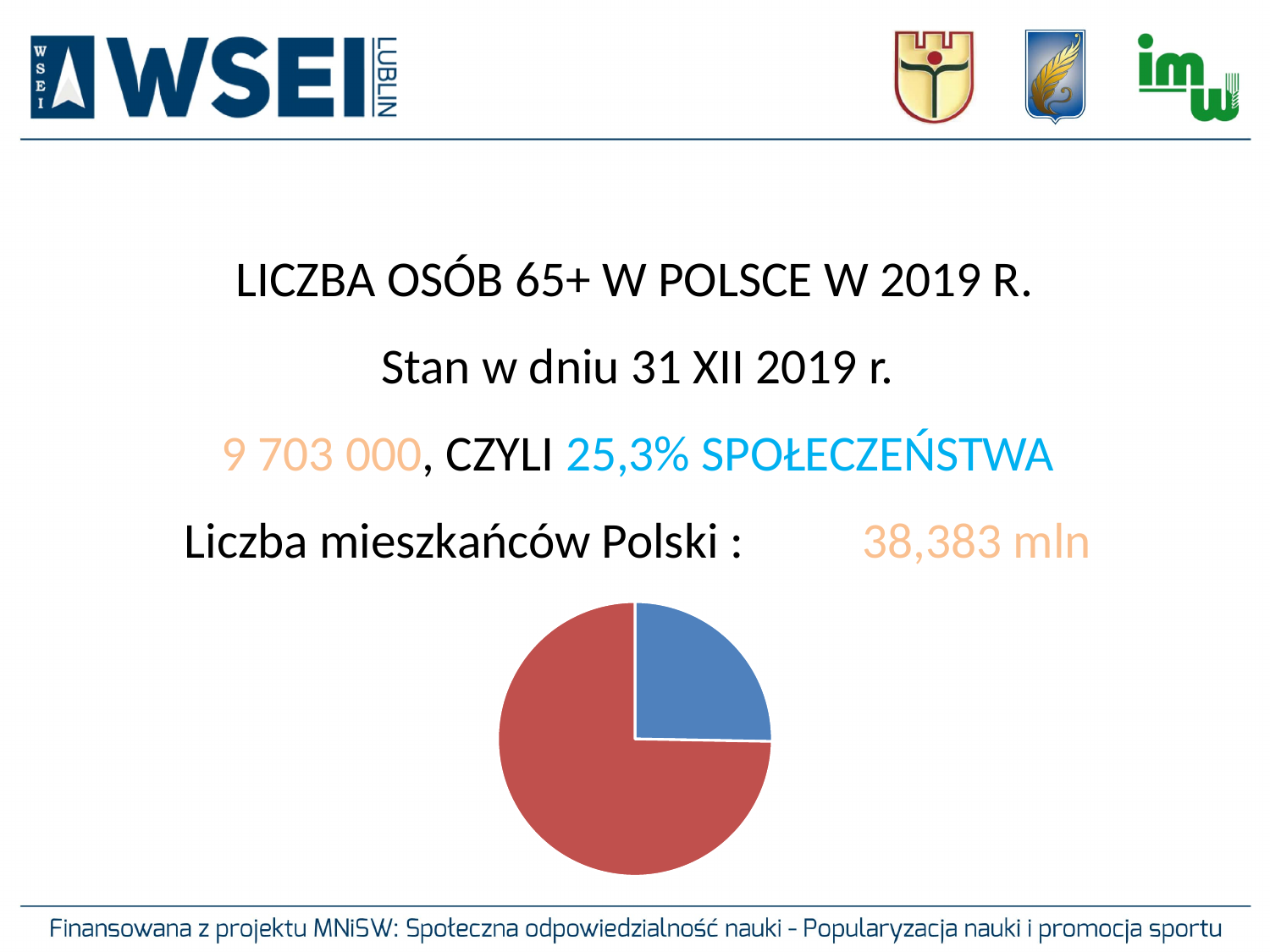
Is the blue slice of the pie chart greater or less than half of the pie? less What two colours are used for the slices of the pie chart? blue and red Which slice of the pie chart is larger, the red one or the blue one? red Which slice of the pie chart is the smallest? the blue slice Which slice of the pie chart is the largest? the red slice How many slices does the pie chart have? 2 Is the red slice of the pie chart greater or less than half of the pie? greater What kind of chart is shown on the slide? pie chart Does the pie chart display a legend? No